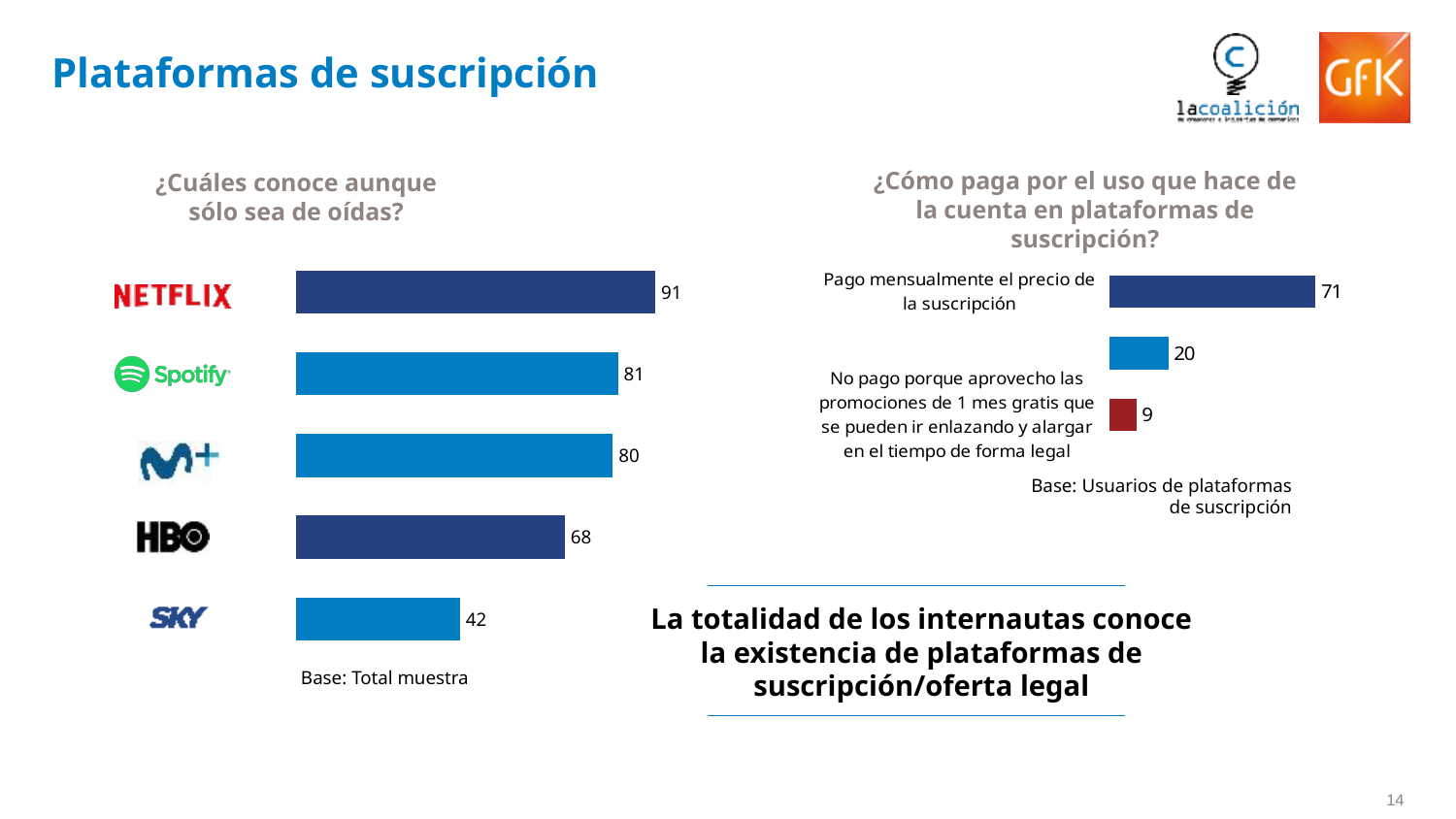
How many platforms are shown in the chart '¿Cuáles conoce aunque sólo sea de oídas?'? 5 In the chart '¿Cómo paga por el uso que hace de la cuenta en plataformas de suscripción?', what is the value for 'Pago mensualmente el precio de la suscripción'? 71 In the chart '¿Cuáles conoce aunque sólo sea de oídas?', what is the difference between the values for Netflix and SKY? 49 In the chart '¿Cuáles conoce aunque sólo sea de oídas?', which platform has the lowest value? SKY What kind of chart is the one titled '¿Cuáles conoce aunque sólo sea de oídas?'? Bar chart In the chart '¿Cuáles conoce aunque sólo sea de oídas?', what is the value for Netflix? 91 How many bars are shown in the chart '¿Cómo paga por el uso que hace de la cuenta en plataformas de suscripción?'? 3 In the chart '¿Cuáles conoce aunque sólo sea de oídas?', what is the value for HBO? 68 In the chart '¿Cuáles conoce aunque sólo sea de oídas?', which platform has the highest value? Netflix In the chart '¿Cuáles conoce aunque sólo sea de oídas?', which is larger, the value for Spotify or the value for HBO? Spotify In the chart '¿Cómo paga por el uso que hace de la cuenta en plataformas de suscripción?', what is the value for 'No pago porque aprovecho las promociones de 1 mes gratis que se pueden ir enlazando y alargar en el tiempo de forma legal'? 9 What is the base noted under the chart '¿Cuáles conoce aunque sólo sea de oídas?'? Total muestra